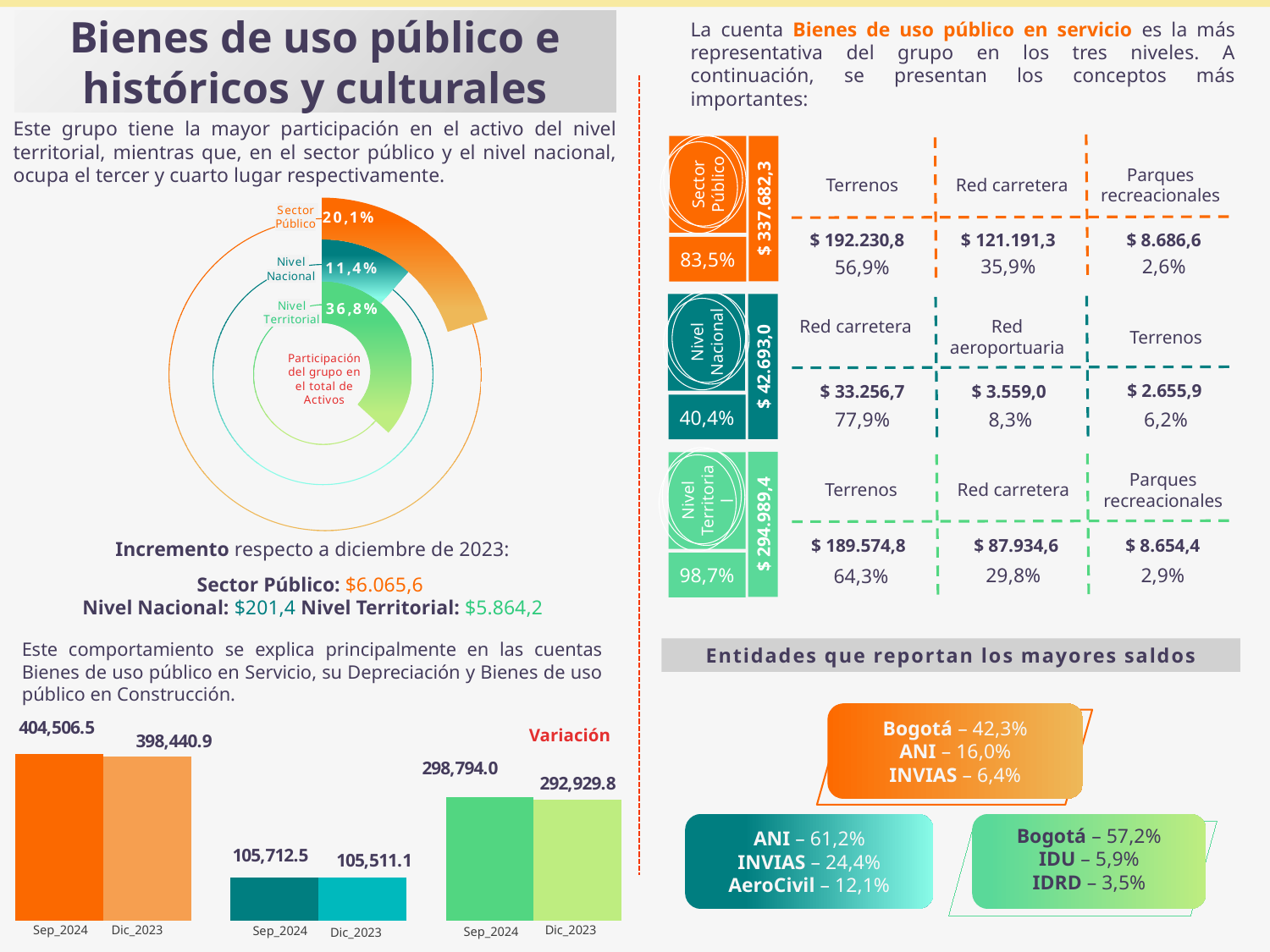
In the radial chart 'Participación del grupo en el total de Activos', how many levels are plotted? 3 In the bar chart at the bottom left, what is the Dic_2023 value of the teal (middle) group? 105,511.1 In the radial chart 'Participación del grupo en el total de Activos', which level has the lowest participation? Nivel Nacional In the bar chart at the bottom left, what is the difference between the Sep_2024 and Dic_2023 values of the orange (leftmost) group? 6,065.6 In the bar chart at the bottom left, which is larger in the green (rightmost) group: Sep_2024 or Dic_2023? Sep_2024 What kind of chart is shown at the bottom left of the slide? Bar chart In the radial chart 'Participación del grupo en el total de Activos', which level has the highest participation? Nivel Territorial In the radial chart 'Participación del grupo en el total de Activos', what is the value for Sector Público? 20,1% In the radial chart 'Participación del grupo en el total de Activos', what is the value for Nivel Territorial? 36,8% In the bar chart at the bottom left, what is the Dic_2023 value of the green (rightmost) group? 292,929.8 In the bar chart at the bottom left, how many bars are shown in total? 6 In the bar chart at the bottom left, what is the Sep_2024 value of the orange (leftmost) group? 404,506.5